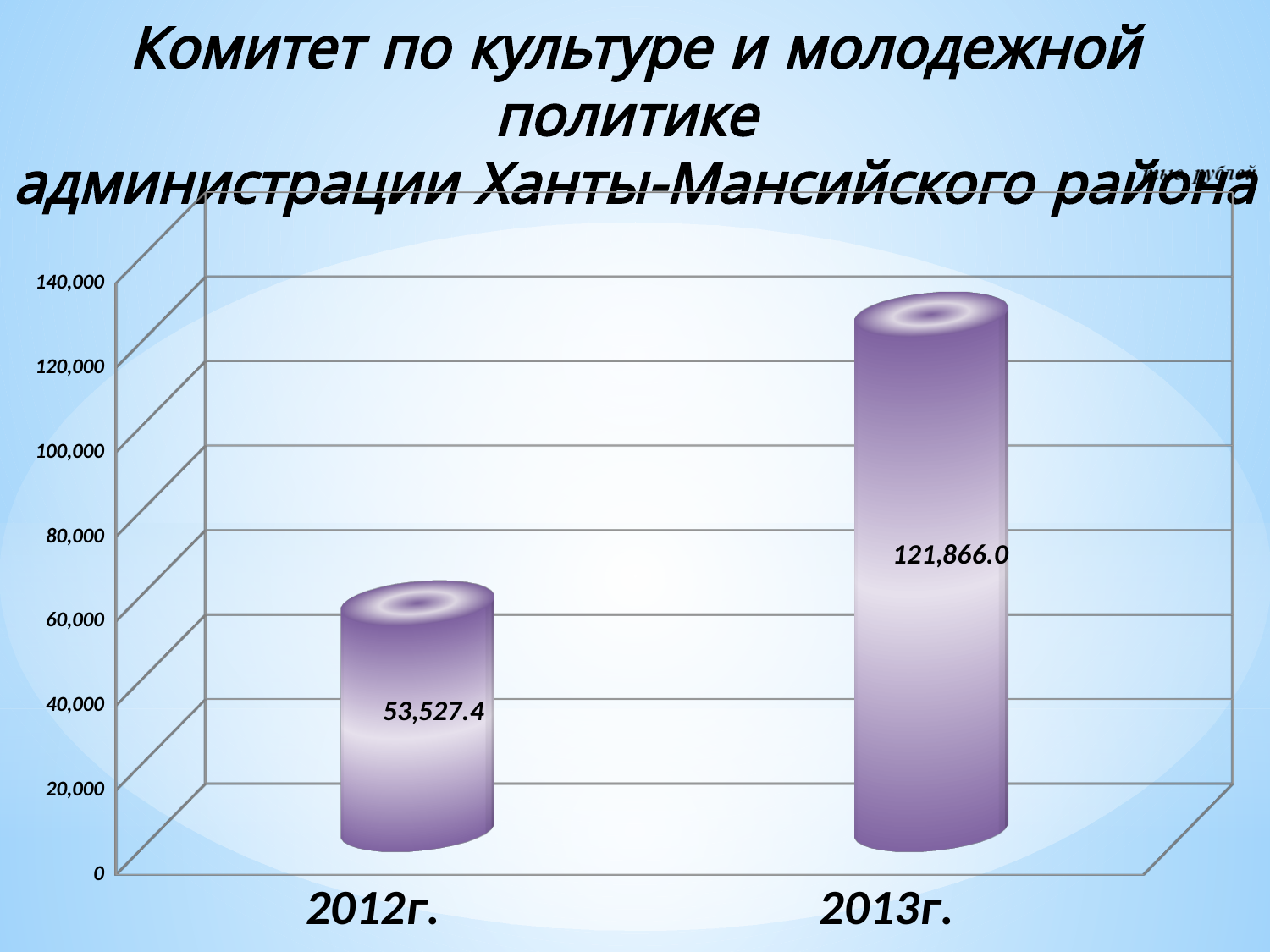
What is the highest tick value shown on the vertical axis? 140,000 Is the value for 2012г. greater or less than 60,000? less How many categories are shown on the x axis? 2 Which year has the lower value? 2012г. What is the value shown for 2012г.? 53,527.4 What is the difference between the values for 2013г. and 2012г.? 68,338.6 Which year has the higher value? 2013г. Is the value for 2012г. larger or smaller than the value for 2013г.? smaller Do the values rise or fall from 2012г. to 2013г.? rise Is the value for 2013г. greater or less than 100,000? greater What kind of chart is shown on the slide? bar chart What is the value shown for 2013г.? 121,866.0